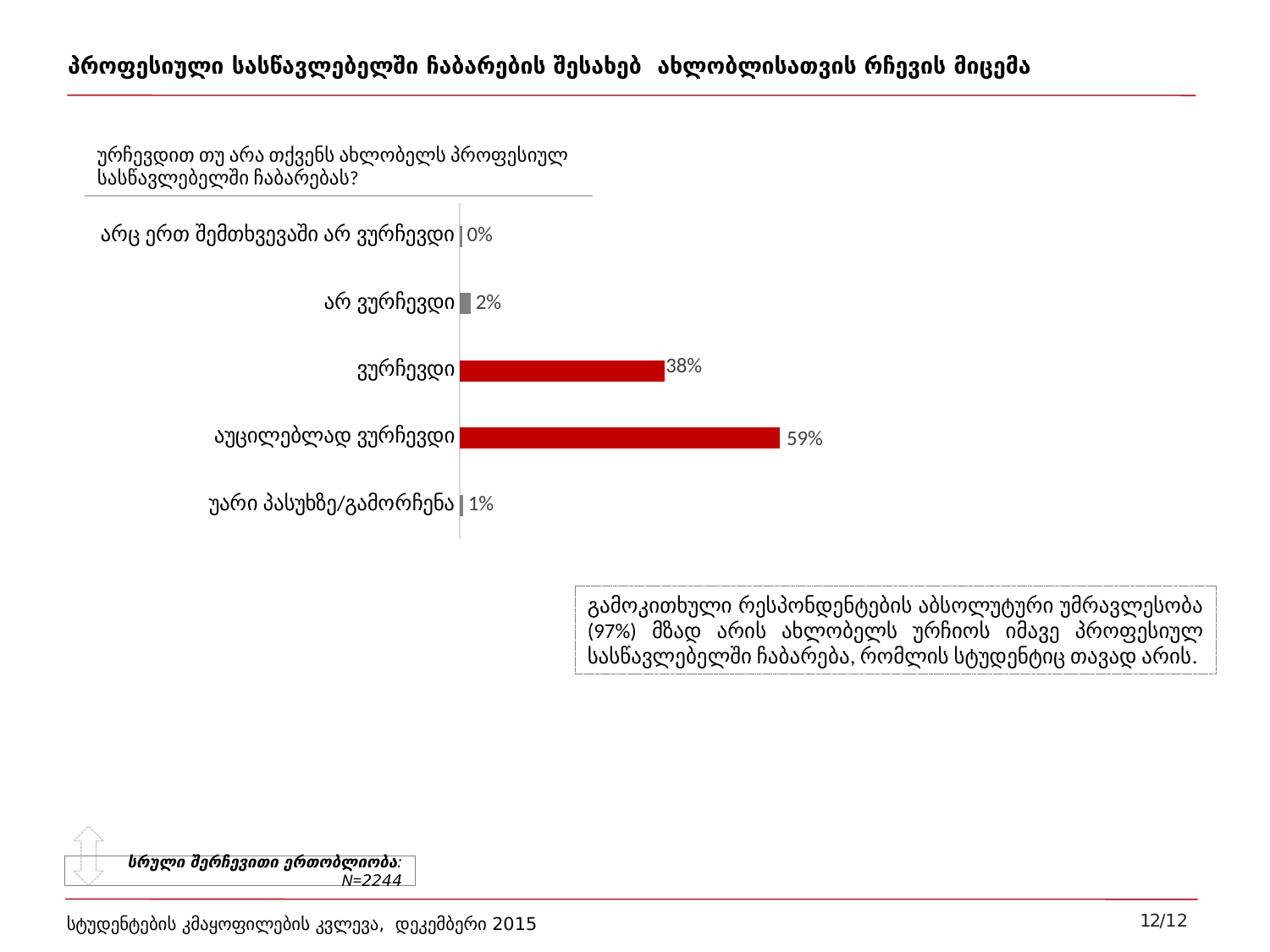
What is the combined value of "ვურჩევდი" and "აუცილებლად ვურჩევდი"? 97% What percentage is shown for "არც ერთ შემთხვევაში არ ვურჩევდი"? 0% Which category has the highest value? აუცილებლად ვურჩევდი What type of chart is shown on the slide? Bar chart What percentage is shown for "ვურჩევდი"? 38% What is the difference between the values for "აუცილებლად ვურჩევდი" and "ვურჩევდი"? 21% How many categories are shown in the chart? 5 Which is larger, the value for "არ ვურჩევდი" or the value for "უარი პასუხზე/გამორჩენა"? არ ვურჩევდი What percentage is shown for "აუცილებლად ვურჩევდი"? 59% What percentage is shown for "უარი პასუხზე/გამორჩენა"? 1% Which category has the lowest value? არც ერთ შემთხვევაში არ ვურჩევდი What percentage is shown for "არ ვურჩევდი"? 2%